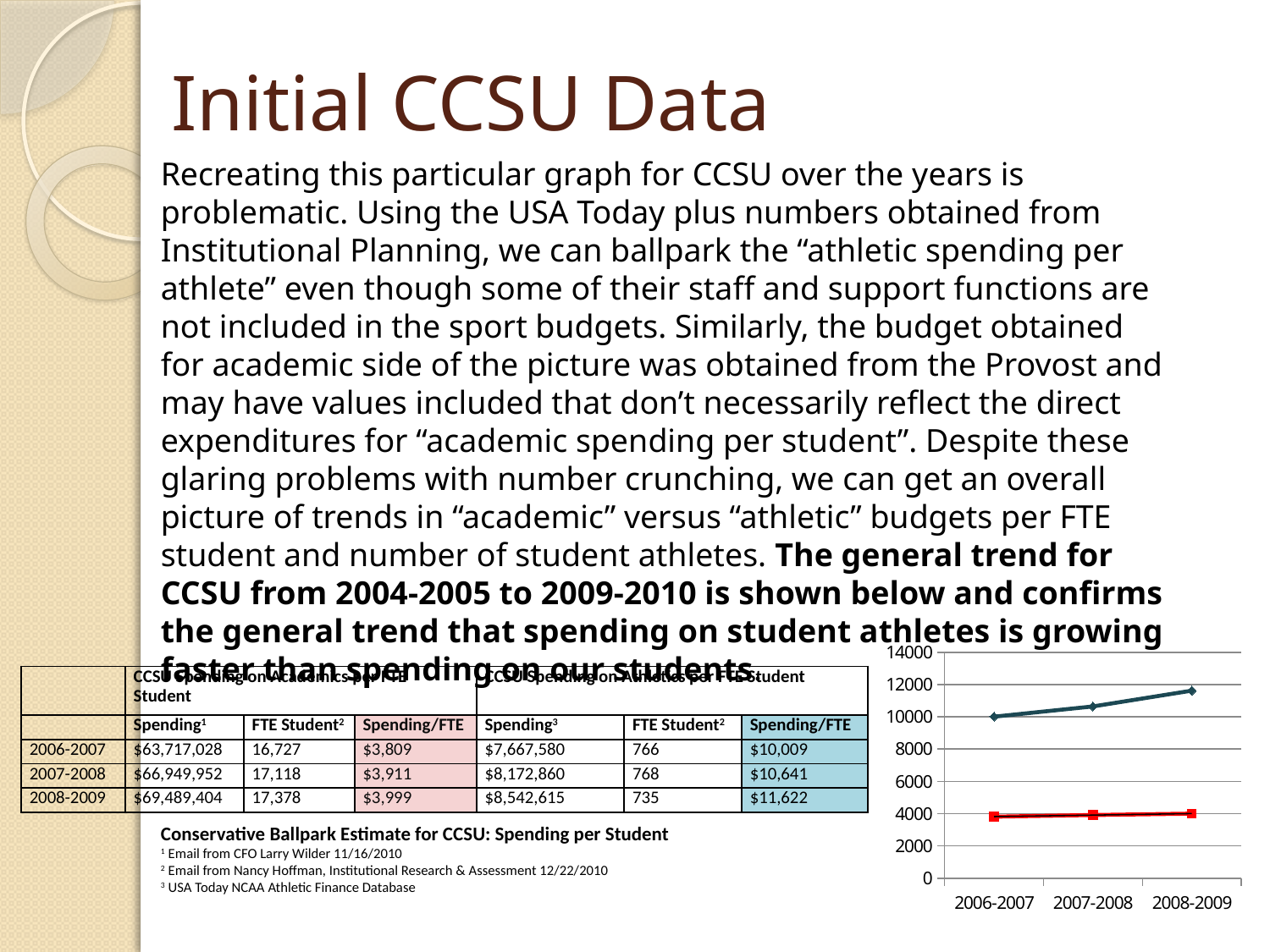
What kind of chart is shown on the slide? line chart In which year does the upper line reach its highest value? 2008-2009 Is the value of the lower line for 2006-2007 greater or less than 2000? greater Is the value of the lower line for 2007-2008 greater or less than 6000? less What is the highest tick value shown on the chart's y axis? 14000 How many categories are shown on the x axis of the chart? 3 Is the value of the upper line for 2008-2009 greater or less than 10000? greater Does the upper line on the chart rise or fall from 2006-2007 to 2008-2009? rise How many lines are plotted on the chart? 2 In which year does the upper line have its lowest value? 2006-2007 At 2008-2009, which line has the larger value, the upper line or the lower line? the upper line